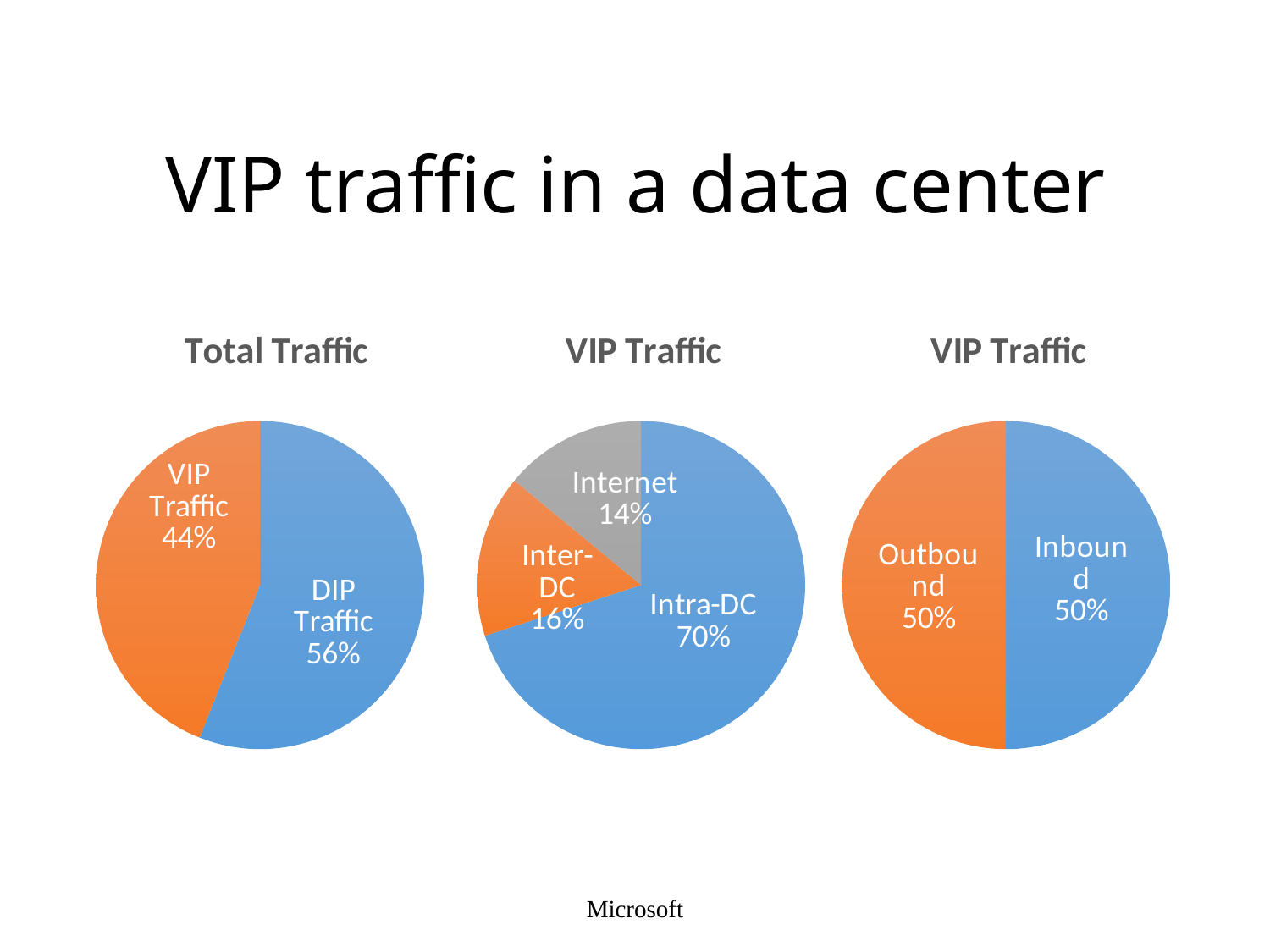
What kind of chart is the 'Total Traffic' chart on the left? Pie chart In the middle 'VIP Traffic' pie chart, which slice is the smallest? Internet How many slices does the middle 'VIP Traffic' pie chart have? 3 In the middle 'VIP Traffic' pie chart, which slice is the largest? Intra-DC In the middle 'VIP Traffic' pie chart, what share is Internet? 14% In the middle 'VIP Traffic' pie chart, what is the difference between the Intra-DC and Inter-DC shares? 54% In the rightmost 'VIP Traffic' pie chart, what share is Outbound? 50% In the 'Total Traffic' pie chart on the left, which slice is larger, VIP Traffic or DIP Traffic? DIP Traffic In the 'Total Traffic' pie chart on the left, what is the difference between the DIP Traffic and VIP Traffic shares? 12% In the 'Total Traffic' pie chart on the left, what share is DIP Traffic? 56%